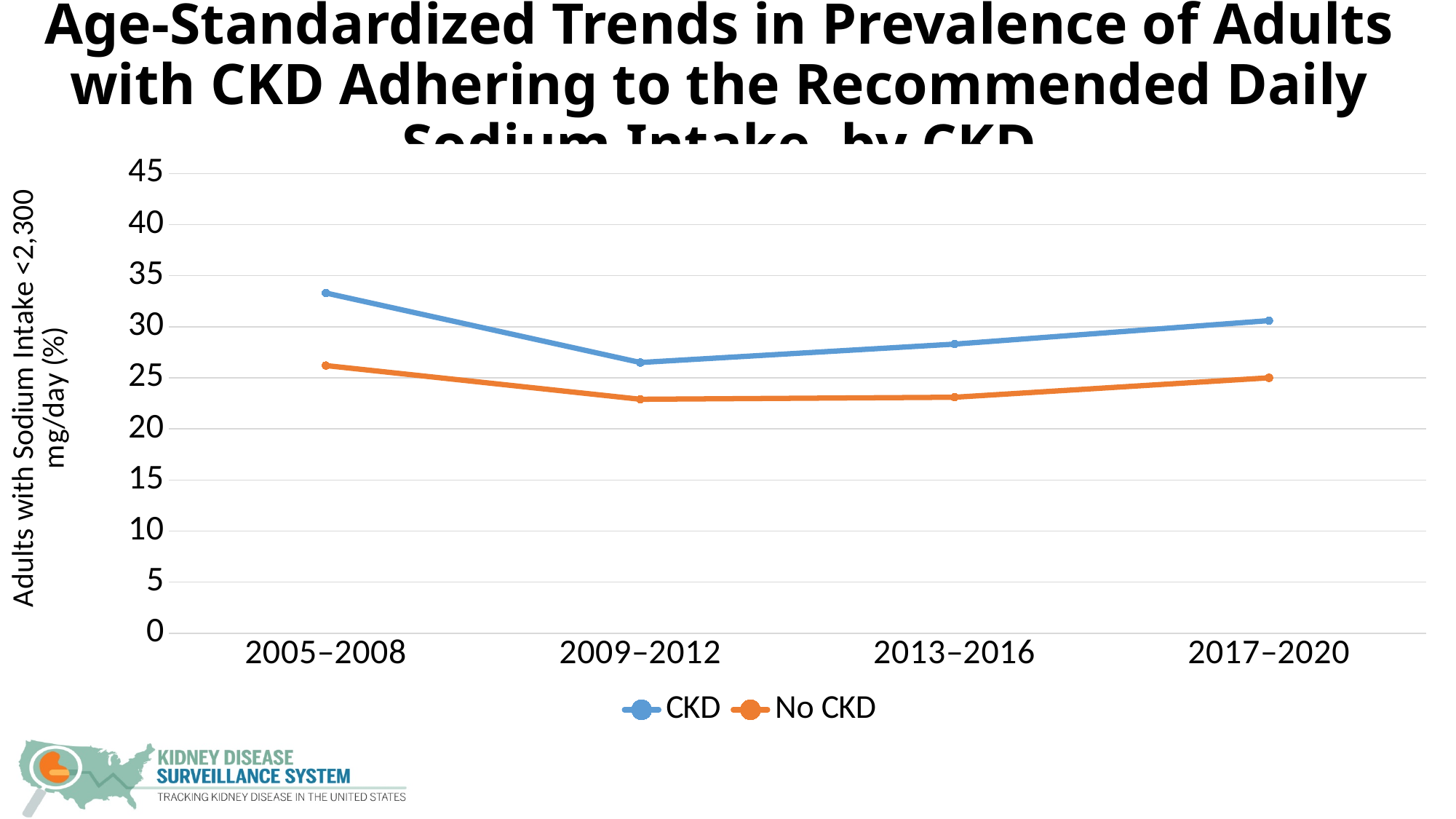
How many series does the legend list? 2 How many time periods are shown on the x axis? 4 Is the value for CKD in 2005–2008 greater or less than 30? greater In which period is the CKD series at its highest? 2005–2008 Does the CKD series rise or fall from 2009–2012 to 2017–2020? rise What kind of chart is shown on the slide? line chart Which series is plotted in orange? No CKD Which series has the higher value in 2017–2020, CKD or No CKD? CKD Is the value for No CKD in 2009–2012 greater or less than 25? less In which period is the No CKD series at its highest? 2005–2008 Is the value for No CKD in 2013–2016 greater or less than 25? less In which period is the CKD series at its lowest? 2009–2012